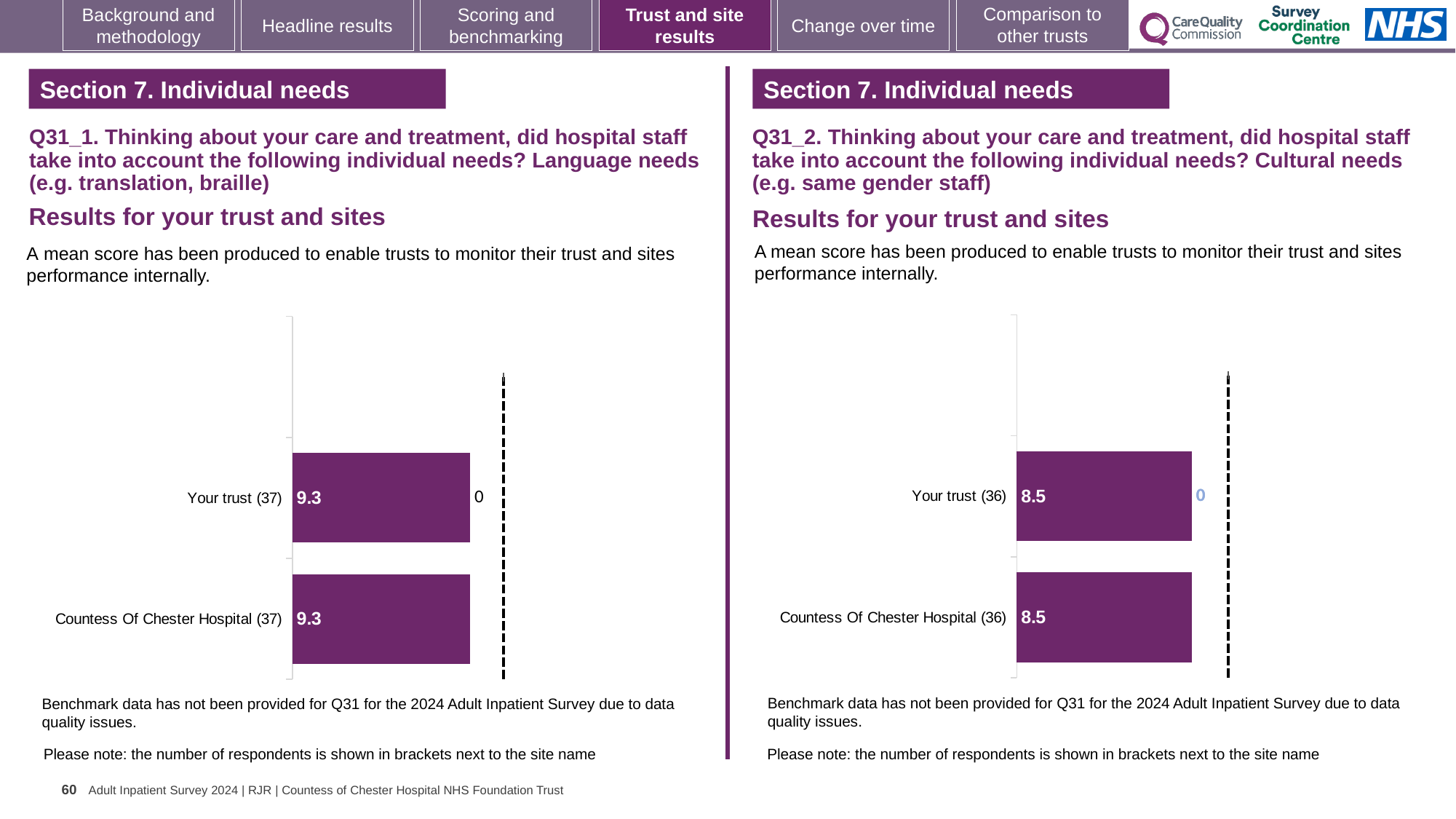
How many bars are plotted in the left chart (Q31_1, Language needs)? 2 In the left chart (Q31_1, Language needs), what is the mean score for Your trust? 9.3 In the left chart (Q31_1, Language needs), what is the difference between the scores for Your trust and Countess Of Chester Hospital? 0.0 In the left chart (Q31_1, Language needs), how many respondents are shown in brackets next to Your trust? 37 In the right chart (Q31_2, Cultural needs), what is the mean score for Your trust? 8.5 In the left chart (Q31_1, Language needs), what is the mean score for Countess Of Chester Hospital? 9.3 In the right chart (Q31_2, Cultural needs), what is the mean score for Countess Of Chester Hospital? 8.5 Is the Your trust score higher in the left chart (Q31_1, Language needs) or the right chart (Q31_2, Cultural needs)? Left chart (Q31_1, Language needs) In the right chart (Q31_2, Cultural needs), what is the difference between the scores for Your trust and Countess Of Chester Hospital? 0.0 In the right chart (Q31_2, Cultural needs), how many respondents are shown in brackets next to Countess Of Chester Hospital? 36 What type of chart is used in the left chart (Q31_1, Language needs)? Bar chart How many bars are plotted in the right chart (Q31_2, Cultural needs)? 2